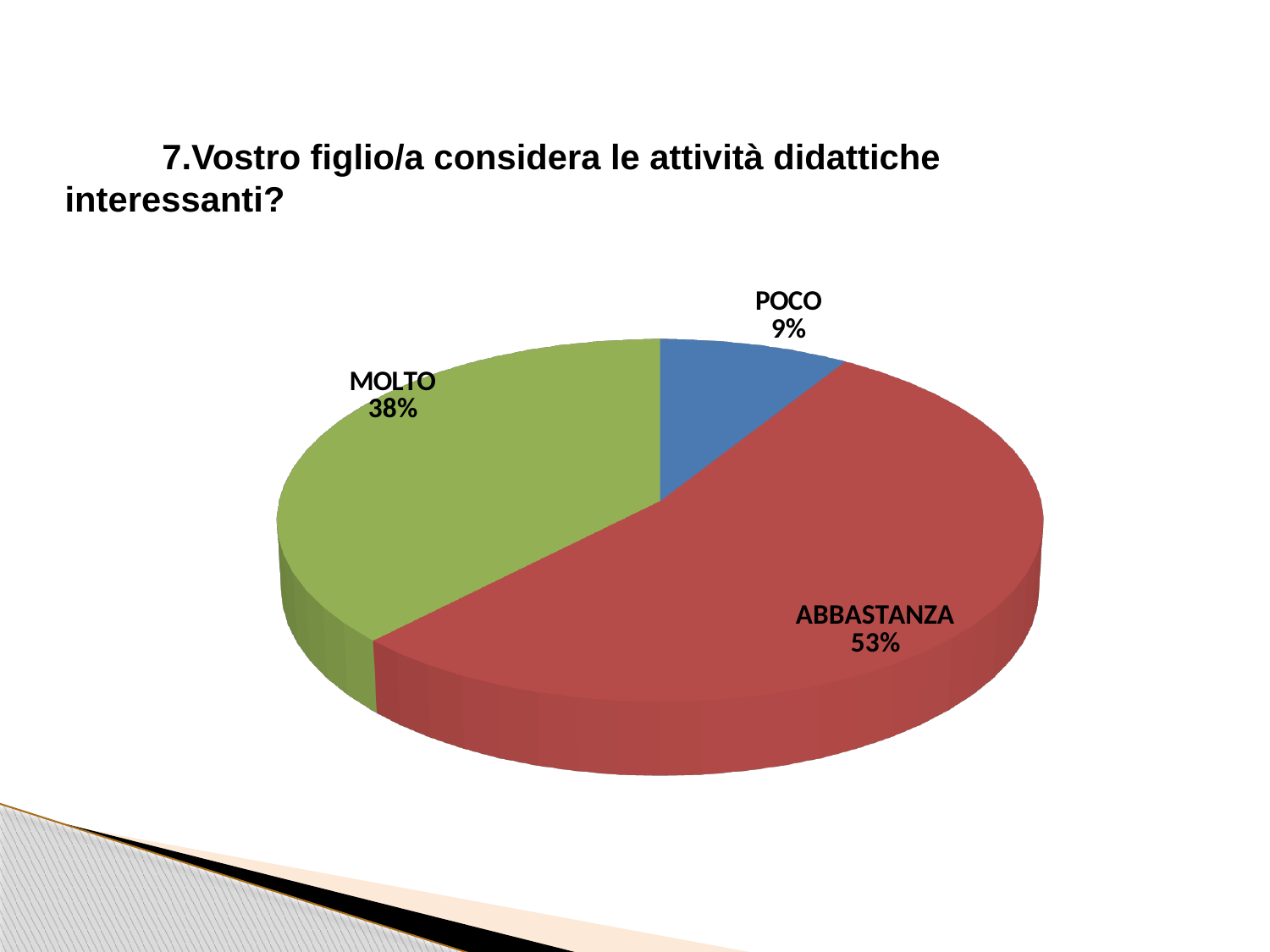
What percentage of the pie is labelled ABBASTANZA? 53% What percentage of the pie is labelled MOLTO? 38% What is the difference in percentage points between the MOLTO and POCO slices? 29 How many slices does the pie chart have? 3 What is the difference in percentage points between the ABBASTANZA and MOLTO slices? 15 Which slice of the pie is the largest? ABBASTANZA What colour is the MOLTO slice? green Which slice of the pie is the smallest? POCO Which slice is larger, MOLTO or POCO? MOLTO What percentage of the pie is labelled POCO? 9% What kind of chart is shown on the slide? pie chart What colour is the ABBASTANZA slice? red